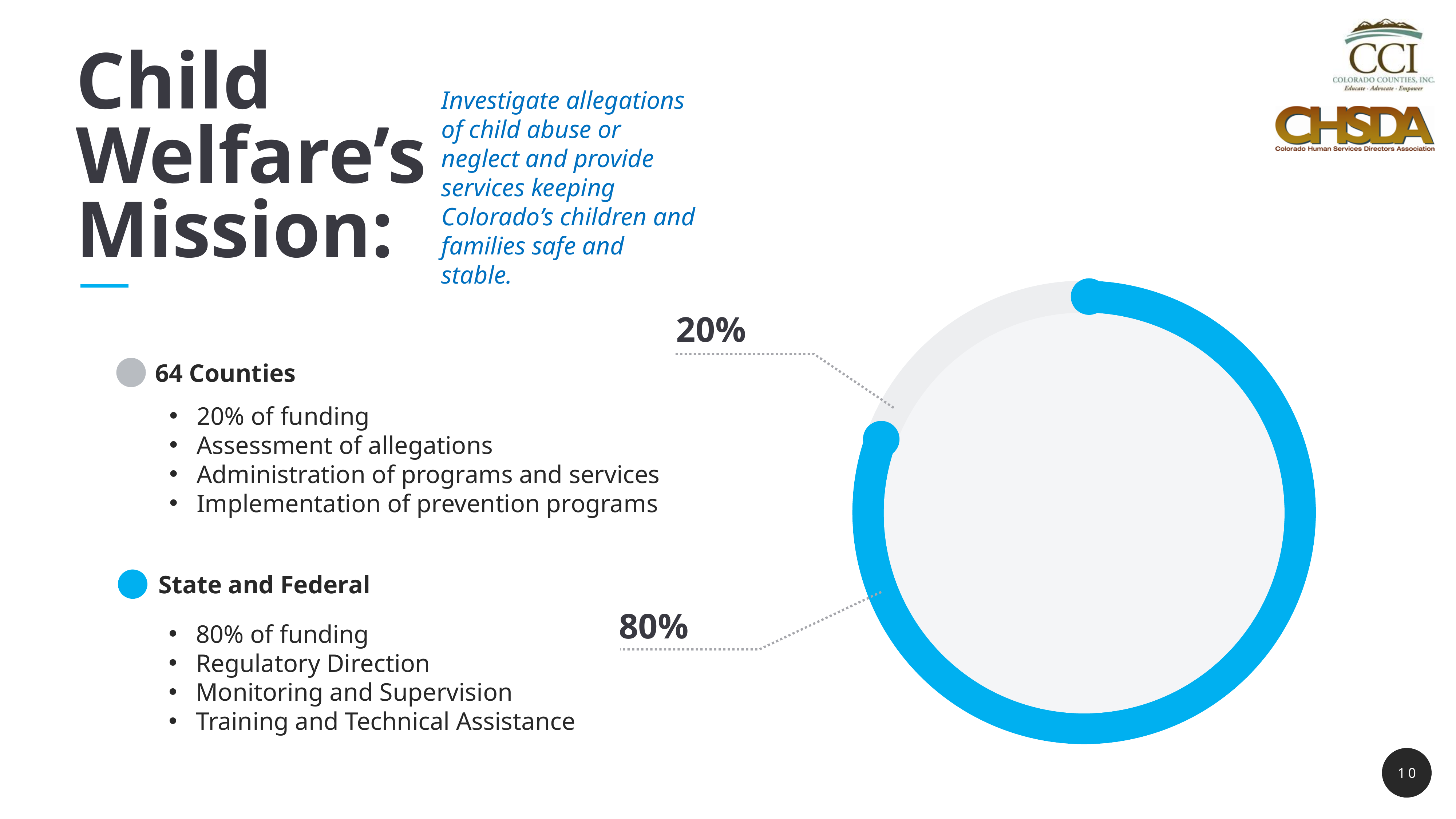
Which funding source has the larger share, 64 Counties or State and Federal? State and Federal What colour represents the 64 Counties funding in the chart? Grey What kind of chart is used to show the funding split? Donut chart What colour represents State and Federal funding in the chart? Blue Which funding source has the smallest share? 64 Counties What share of funding comes from State and Federal sources? 80% What share of funding comes from the 64 Counties? 20% What is the total of the two funding shares shown in the chart? 100% How many funding sources are shown in the chart? 2 What is the difference between the State and Federal share and the 64 Counties share? 60%